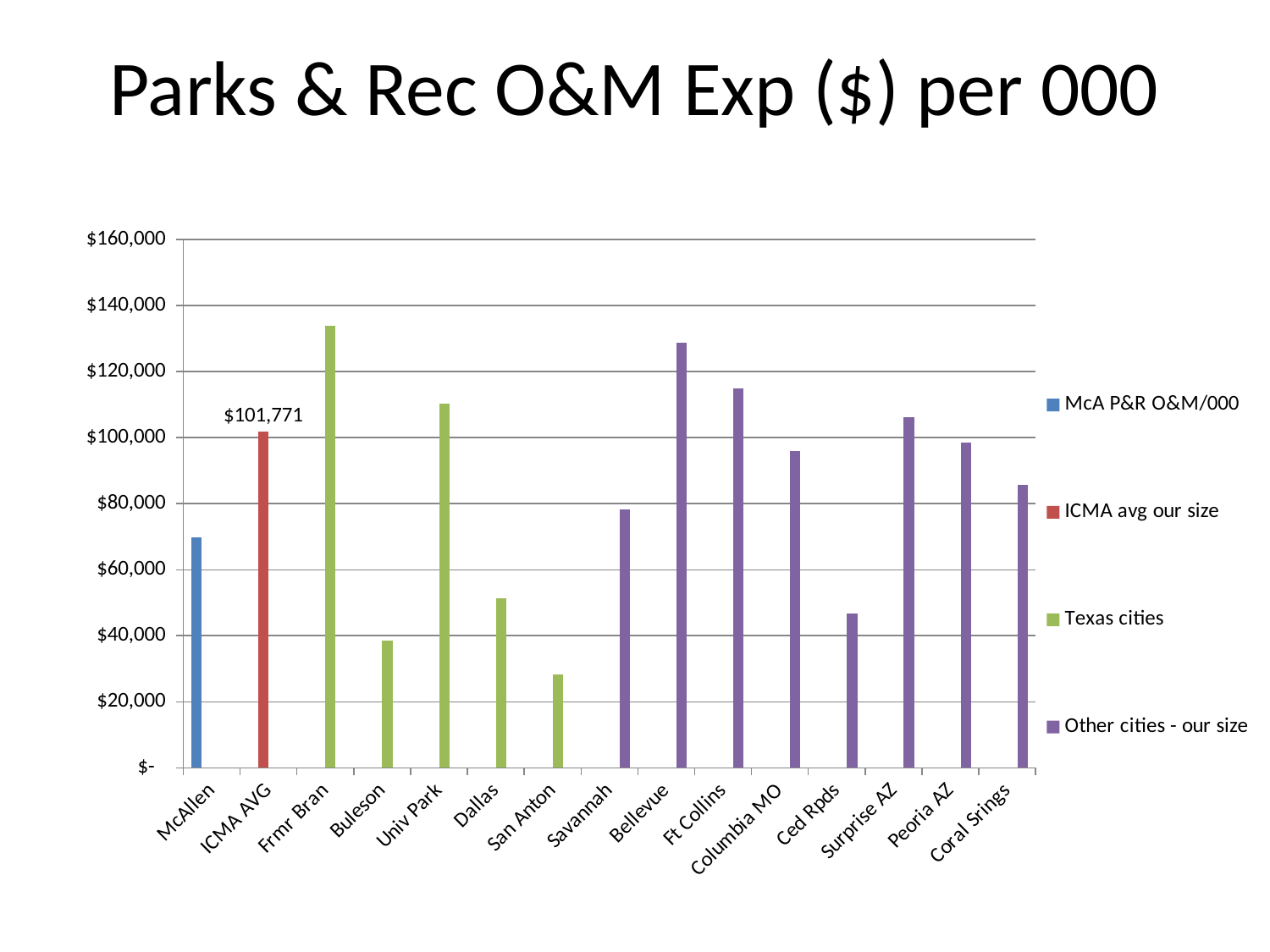
What is the value shown for ICMA AVG? $101,771 What kind of chart is shown on the slide? Bar chart Which category has the highest value? Frmr Bran Is the value for Buleson greater or less than $40,000? less Which category has the lowest value? San Anton How many series does the legend list? 4 How many cities/categories are shown along the x axis? 15 Is the value for McAllen greater or less than $80,000? less Which is larger, the value for Ft Collins or the value for Columbia MO? Ft Collins Is the value for Bellevue greater or less than $120,000? greater Which is larger, the value for McAllen or the value for ICMA AVG? ICMA AVG Which legend series is shown in purple? Other cities - our size